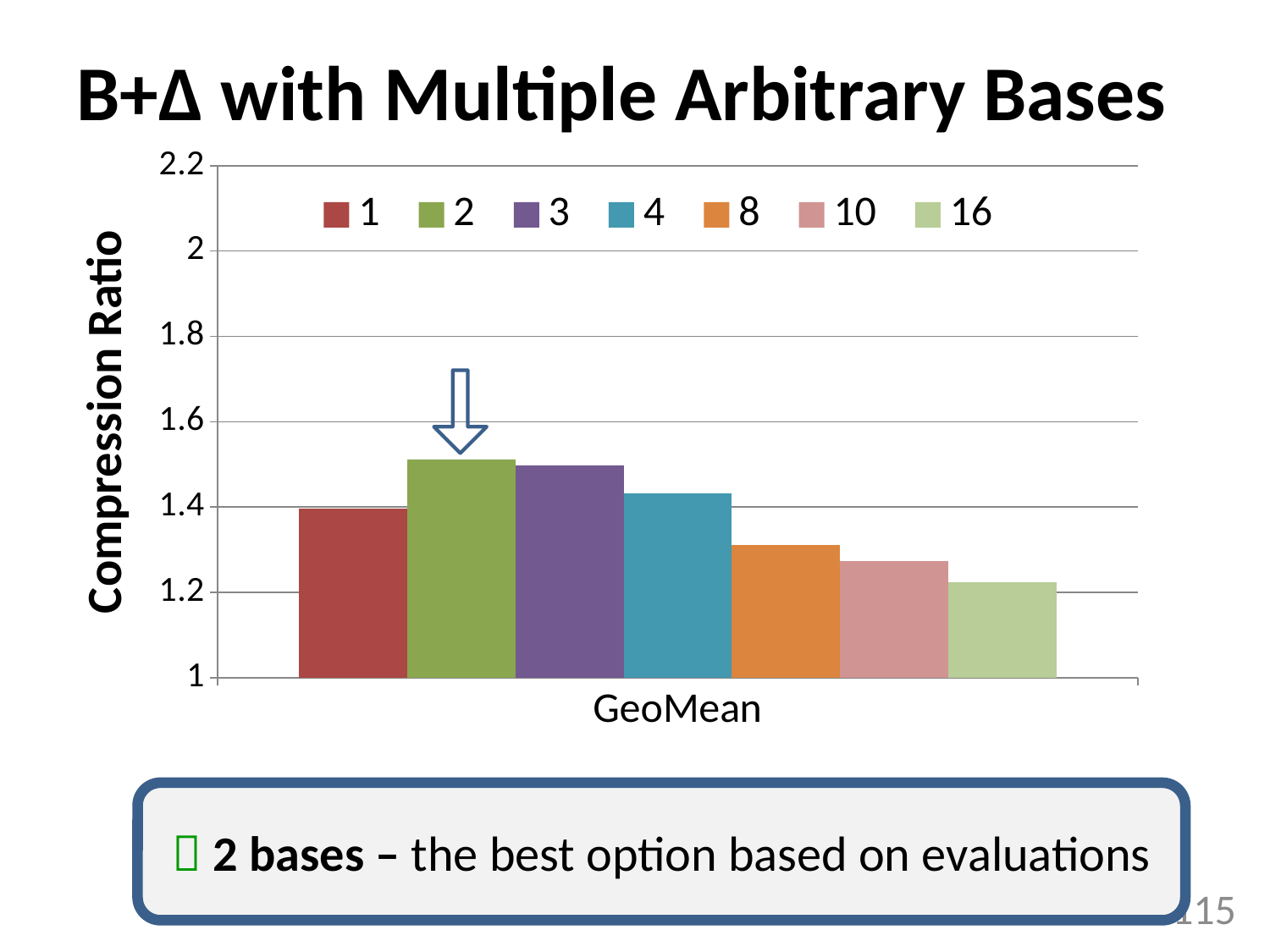
Is the compression ratio for series 10 greater or less than 1.4? less Is the compression ratio for series 4 greater or less than 1.6? less What is the title of the vertical axis? Compression Ratio What kind of chart is shown on the slide? bar chart What is the label of the category on the x axis? GeoMean Which has the larger compression ratio, series 4 or series 16? 4 How many categories are shown on the x axis? 1 Which series has the lowest compression ratio for GeoMean? 16 Is the compression ratio for series 8 greater or less than 1.4? less How many series does the legend list? 7 Which has the larger compression ratio, series 2 or series 8? 2